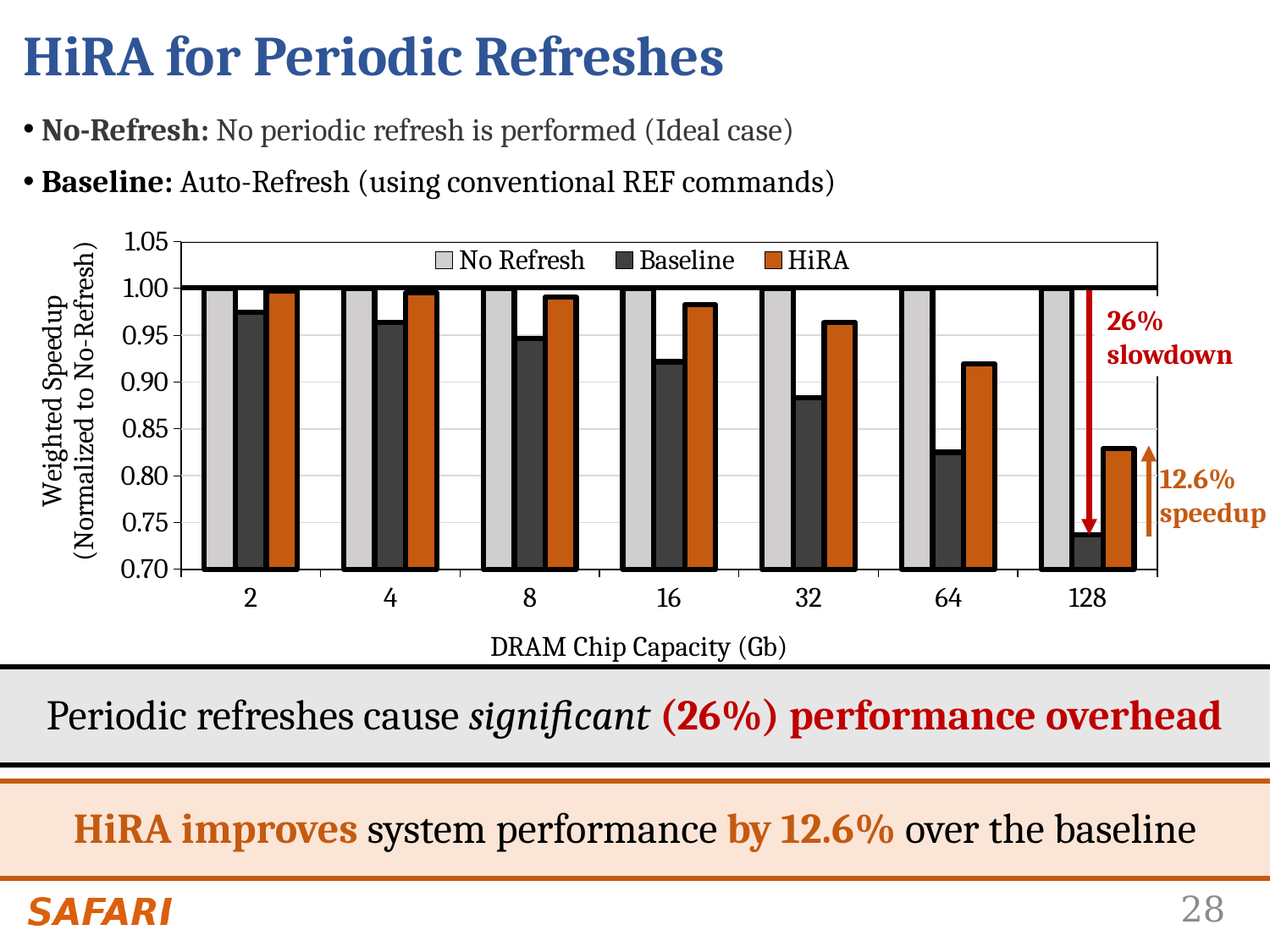
Does the Baseline weighted speedup rise or fall as DRAM chip capacity increases? fall Is the Baseline value at 64 Gb greater or less than 0.80? greater Which series has the lowest weighted speedup at 128 Gb? Baseline Is the HiRA value at 64 Gb greater or less than 0.90? greater How many series does the chart legend list? 3 What slowdown does the annotation on the chart give for the Baseline at 128 Gb? 26% What is the label of the chart's x axis? DRAM Chip Capacity (Gb) What kind of chart is shown on the slide? bar chart How many DRAM chip capacity categories are shown on the x axis? 7 At 128 Gb, which is larger: the HiRA bar or the Baseline bar? HiRA Is the Baseline value at 32 Gb greater or less than 0.90? less At which DRAM chip capacity is the Baseline weighted speedup lowest? 128